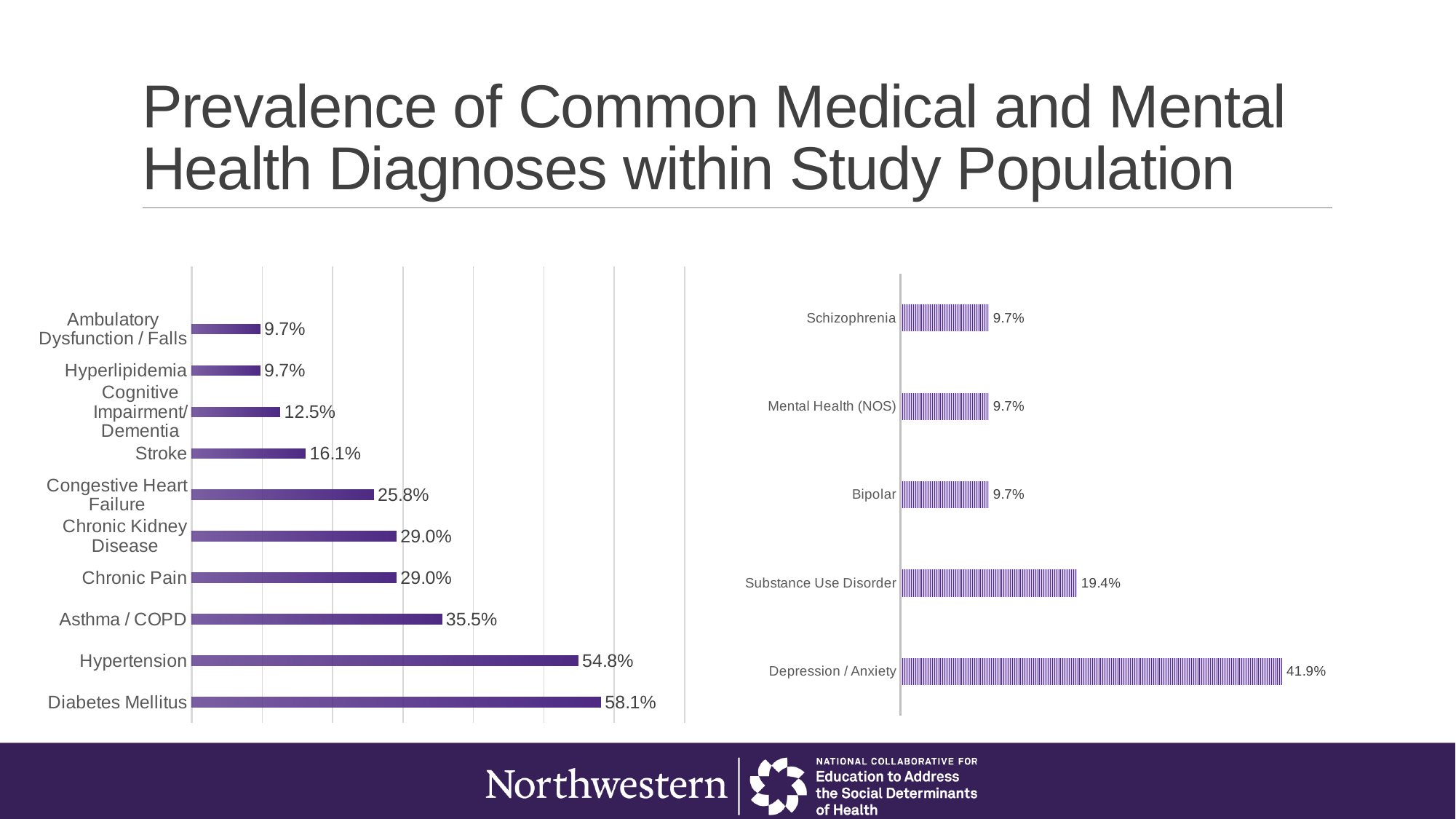
In the left chart (medical diagnoses), what is the value for Hypertension? 54.8% In the right chart (mental health diagnoses), what is the value for Substance Use Disorder? 19.4% In the left chart (medical diagnoses), which is larger, Asthma / COPD or Congestive Heart Failure? Asthma / COPD In the right chart (mental health diagnoses), what is the difference between Depression / Anxiety and Substance Use Disorder? 22.5% How many categories are shown in the left chart (medical diagnoses)? 10 In the right chart (mental health diagnoses), which category has the highest value? Depression / Anxiety In the left chart (medical diagnoses), which category has the lowest value, Stroke or Cognitive Impairment/Dementia? Cognitive Impairment/Dementia How many categories are shown in the right chart (mental health diagnoses)? 5 In the left chart (medical diagnoses), what is the difference between Diabetes Mellitus and Hypertension? 3.3% In the left chart (medical diagnoses), which category has the highest value? Diabetes Mellitus In the left chart (medical diagnoses), what is the value for Stroke? 16.1% What kind of chart is the left chart (medical diagnoses)? Bar chart